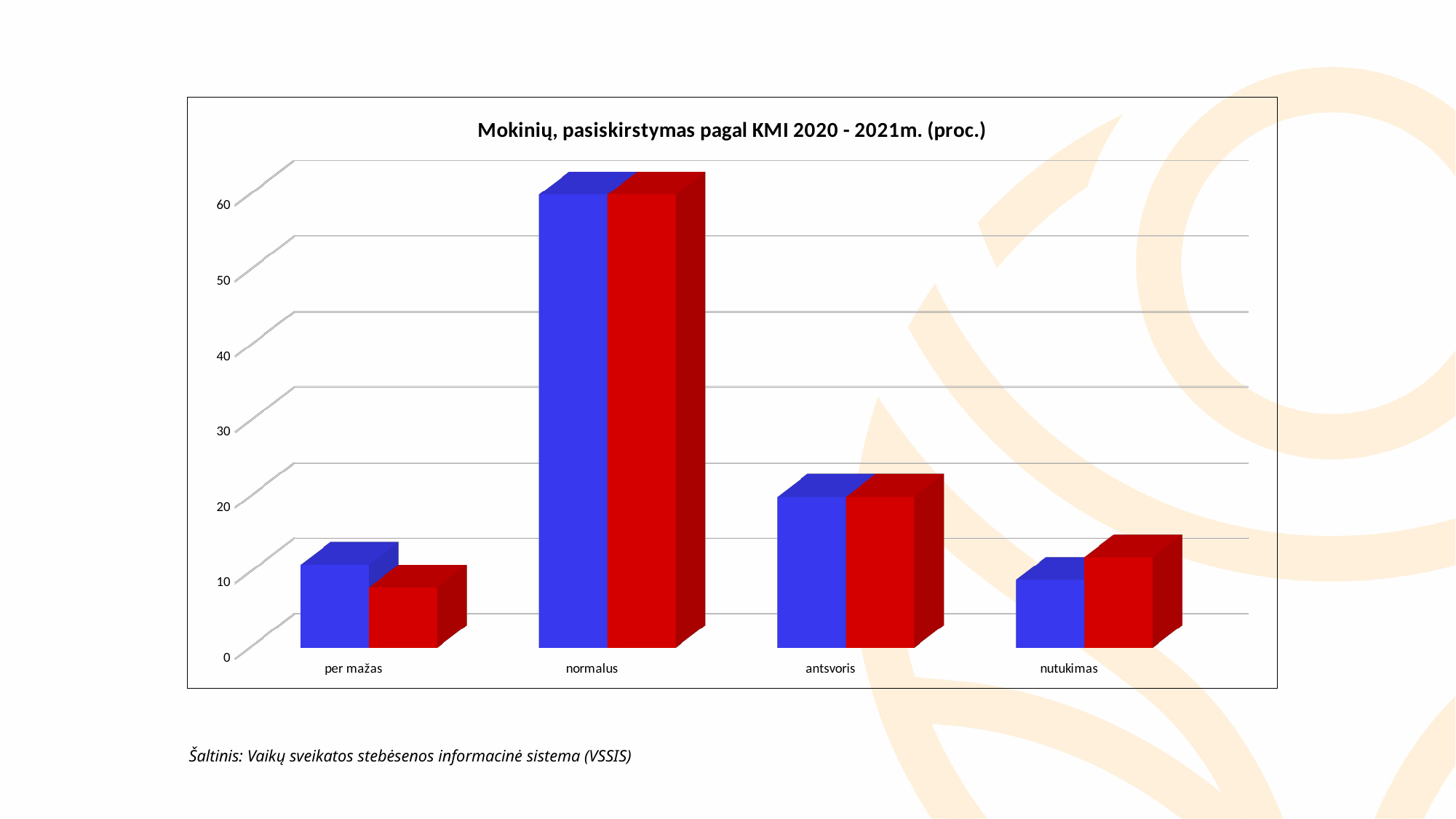
Is the value of the blue bar for normalus greater or less than 50? greater What kind of chart is shown on the slide? bar chart For the category nutukimas, which bar is taller: the blue one or the red one? red Is the value of the red bar for nutukimas greater or less than 20? less For the category per mažas, which bar is taller: the blue one or the red one? blue Is the value of the red bar for antsvoris greater or less than 30? less What is the title of the chart? Mokinių, pasiskirstymas pagal KMI 2020 - 2021m. (proc.) Which is larger for the blue series: normalus or antsvoris? normalus How many categories are shown on the x axis of the chart? 4 Which category has the highest bars in the chart? normalus How many bars are plotted for each category in the chart? 2